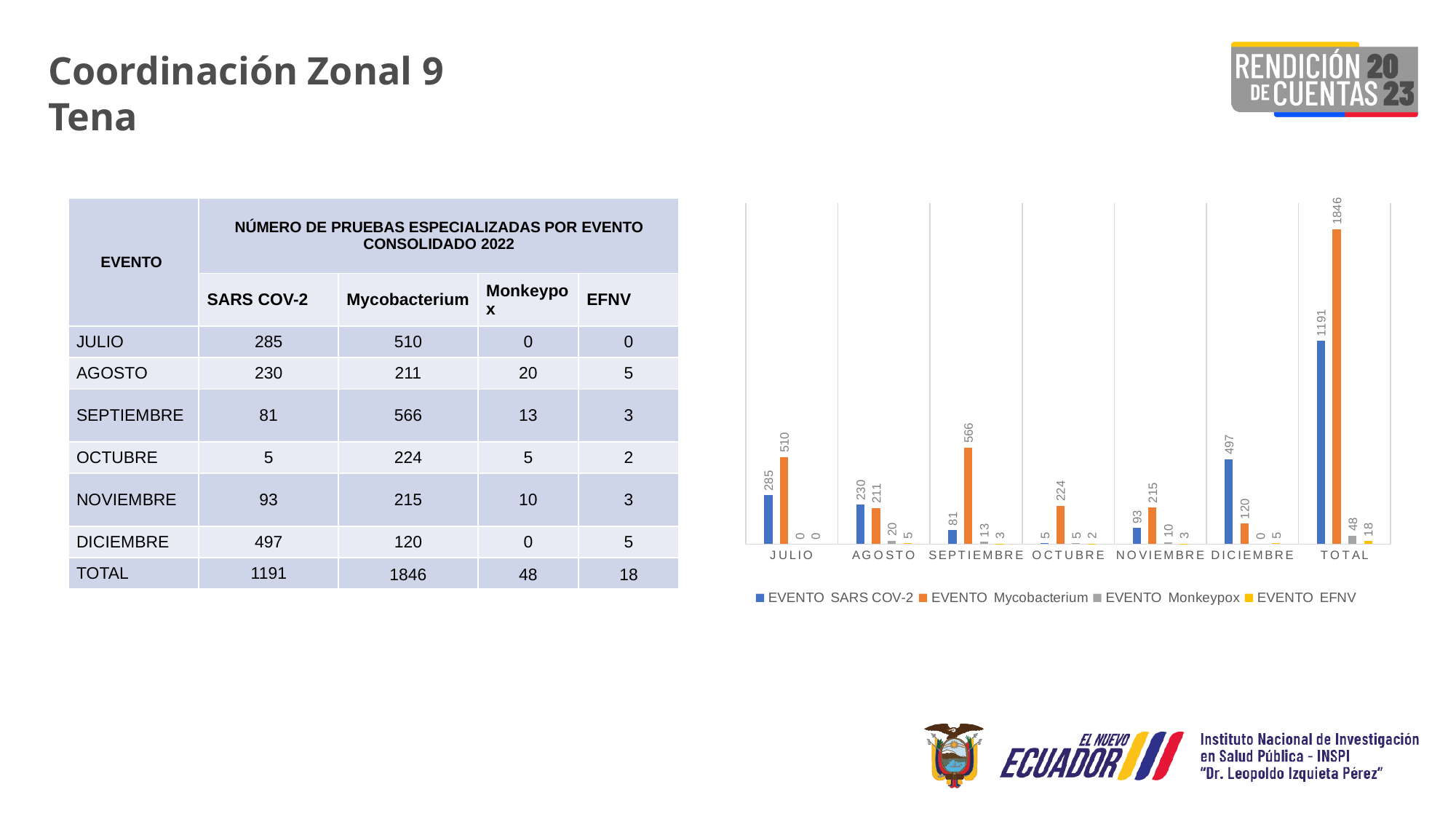
Which month has the lowest value for EVENTO Mycobacterium? DICIEMBRE What is the value for EVENTO SARS COV-2 in DICIEMBRE? 497 How many series does the chart legend list? 4 Which month has the highest value for EVENTO SARS COV-2 (excluding TOTAL)? DICIEMBRE What is the value for EVENTO Mycobacterium in SEPTIEMBRE? 566 What kind of chart is shown on the slide? bar chart What is the value for EVENTO Monkeypox in AGOSTO? 20 Which colour represents EVENTO EFNV in the chart? yellow In JULIO, which is larger: EVENTO SARS COV-2 or EVENTO Mycobacterium? EVENTO Mycobacterium What is the difference between EVENTO Mycobacterium and EVENTO SARS COV-2 in the TOTAL category? 655 How many categories are shown on the x axis of the chart? 7 What is the value for EVENTO EFNV in the TOTAL category? 18